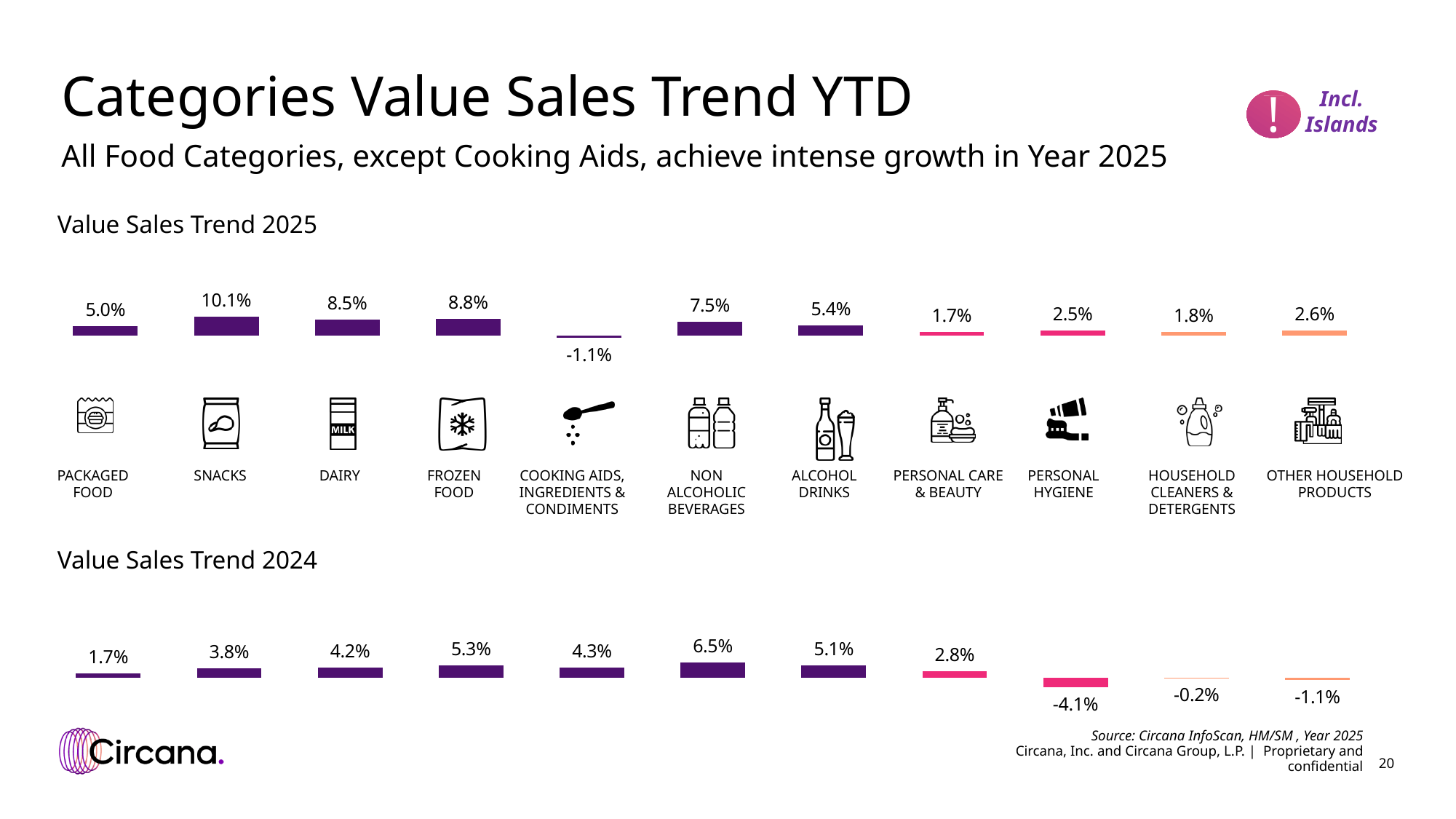
In the Value Sales Trend 2025 chart, which is larger: the value for Frozen Food or the value for Non Alcoholic Beverages? Frozen Food In the Value Sales Trend 2024 chart, which category has the highest value? Non Alcoholic Beverages How many categories are shown in the Value Sales Trend 2025 chart? 11 In the Value Sales Trend 2024 chart, what is the value for Household Cleaners & Detergents? -0.2% In the Value Sales Trend 2025 chart, which category has the lowest value? Cooking Aids, Ingredients & Condiments What is the difference between the Value Sales Trend 2025 and Value Sales Trend 2024 values for Dairy? 4.3 percentage points In the Value Sales Trend 2024 chart, what is the value for Personal Hygiene? -4.1% In the Value Sales Trend 2025 chart, what is the value for Snacks? 10.1% In the Value Sales Trend 2025 chart, which category has the highest value? Snacks In the Value Sales Trend 2025 chart, what is the value for Cooking Aids, Ingredients & Condiments? -1.1% In the Value Sales Trend 2024 chart, which category has the lowest value? Personal Hygiene What kind of chart is the Value Sales Trend 2024 chart? Bar chart